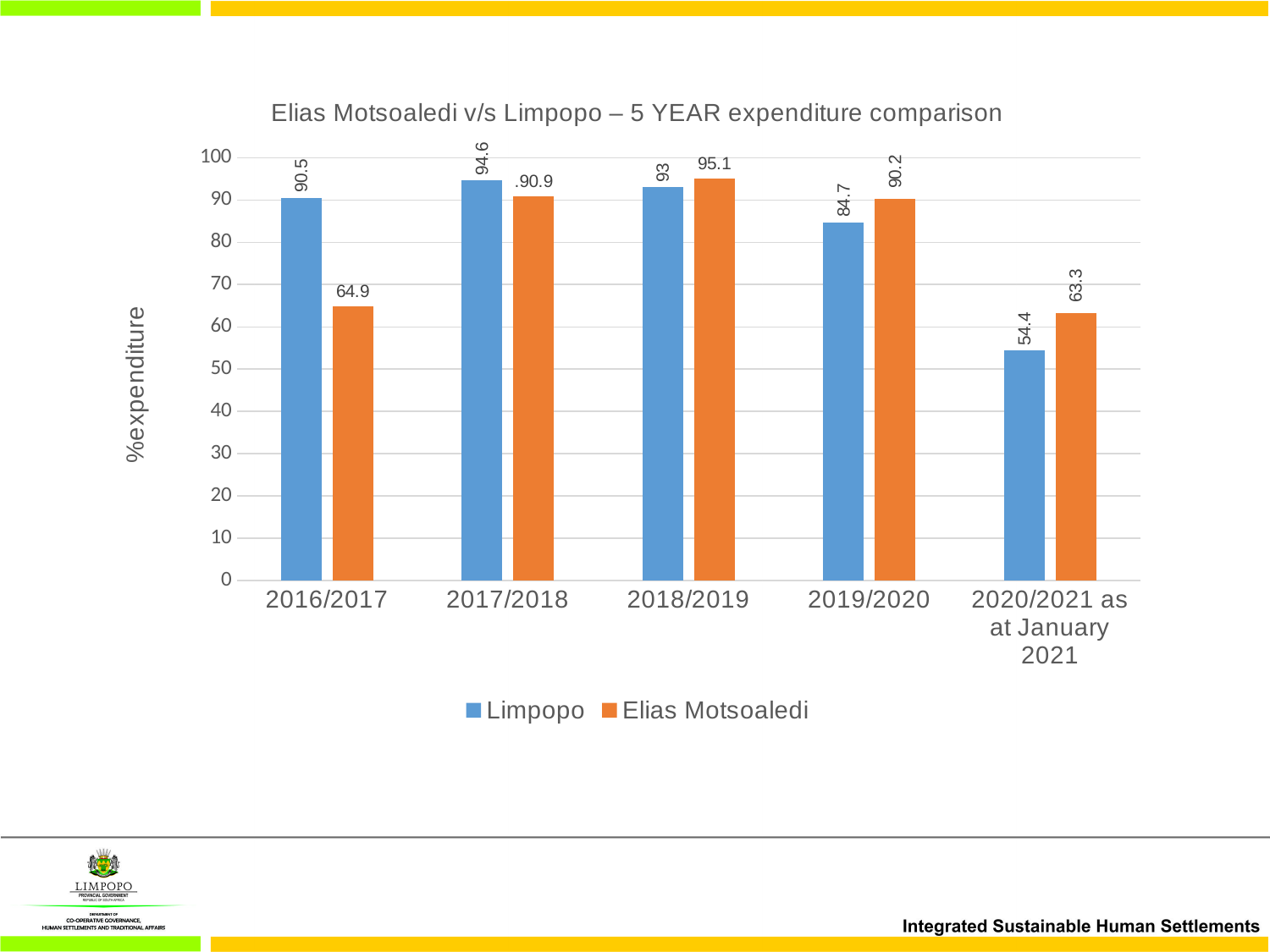
What is the label on the vertical axis? %expenditure What is the Elias Motsoaledi value for 2018/2019? 95.1 How many year categories are shown on the x axis? 5 Which is larger for 2016/2017, the Limpopo value or the Elias Motsoaledi value? Limpopo How many series does the legend list? 2 In which year is the Elias Motsoaledi value lowest? 2020/2021 as at January 2021 What type of chart is shown on the slide? bar chart What is the difference between the Elias Motsoaledi and Limpopo values for 2019/2020? 5.5 What is the Limpopo value for 2016/2017? 90.5 What is the Elias Motsoaledi value for 2016/2017? 64.9 In which year is the Limpopo value highest? 2017/2018 What is the Limpopo value for 2020/2021 as at January 2021? 54.4